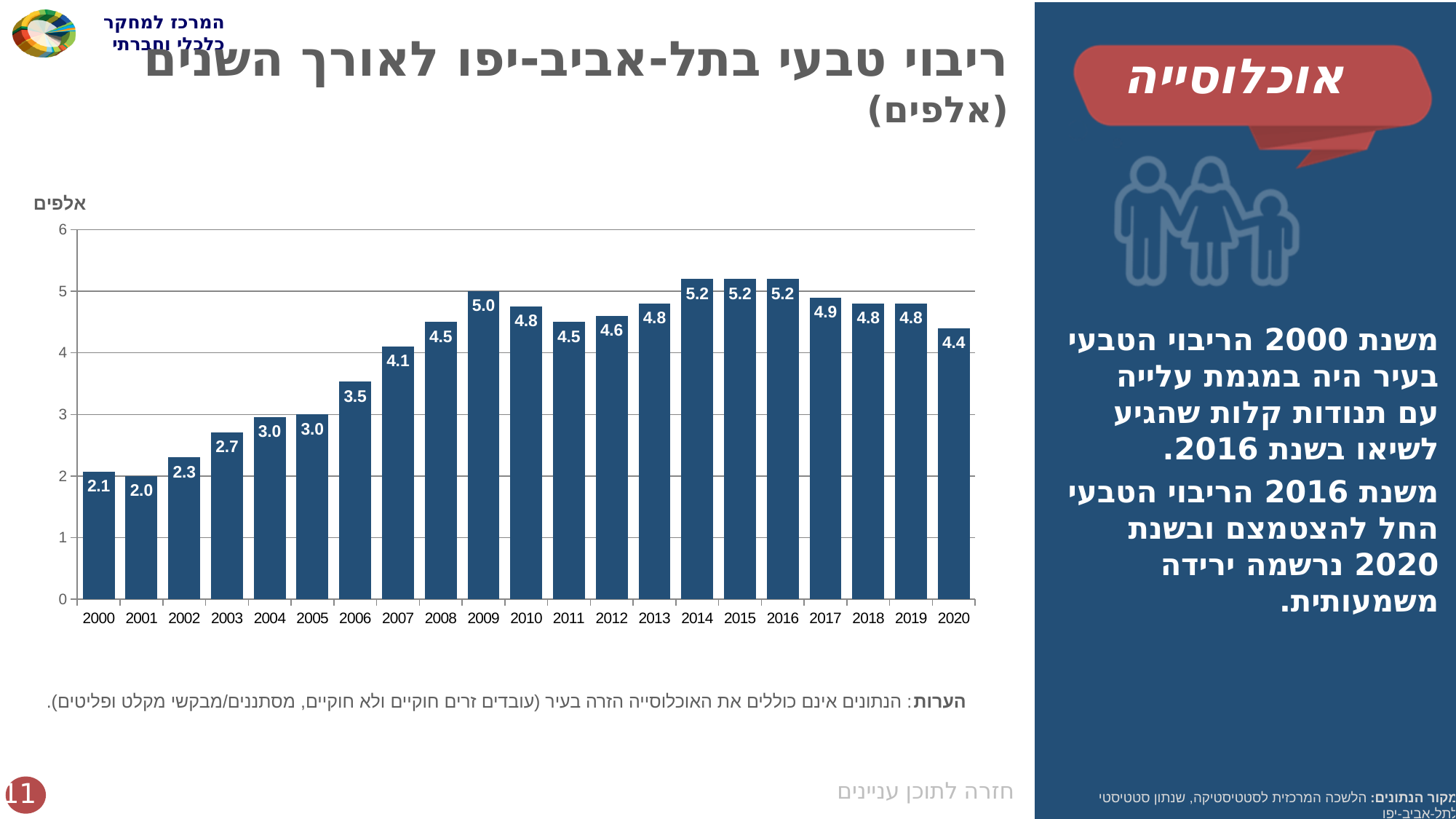
Which is larger, the value for 2007 or the value for 2012? 2012 What is the difference between the values for 2000 and 2009? 2.9 Do the values generally rise or fall from 2000 to 2009? Rise What kind of chart is shown on the slide? Bar chart What is the difference between the values for 2016 and 2020? 0.8 How many years are shown on the x axis? 21 What is the value for 2020? 4.4 What is the value for 2016? 5.2 Which year has the lowest value? 2001 What is the value for 2000? 2.1 What is the value for 2009? 5.0 What is the highest value shown on the chart? 5.2